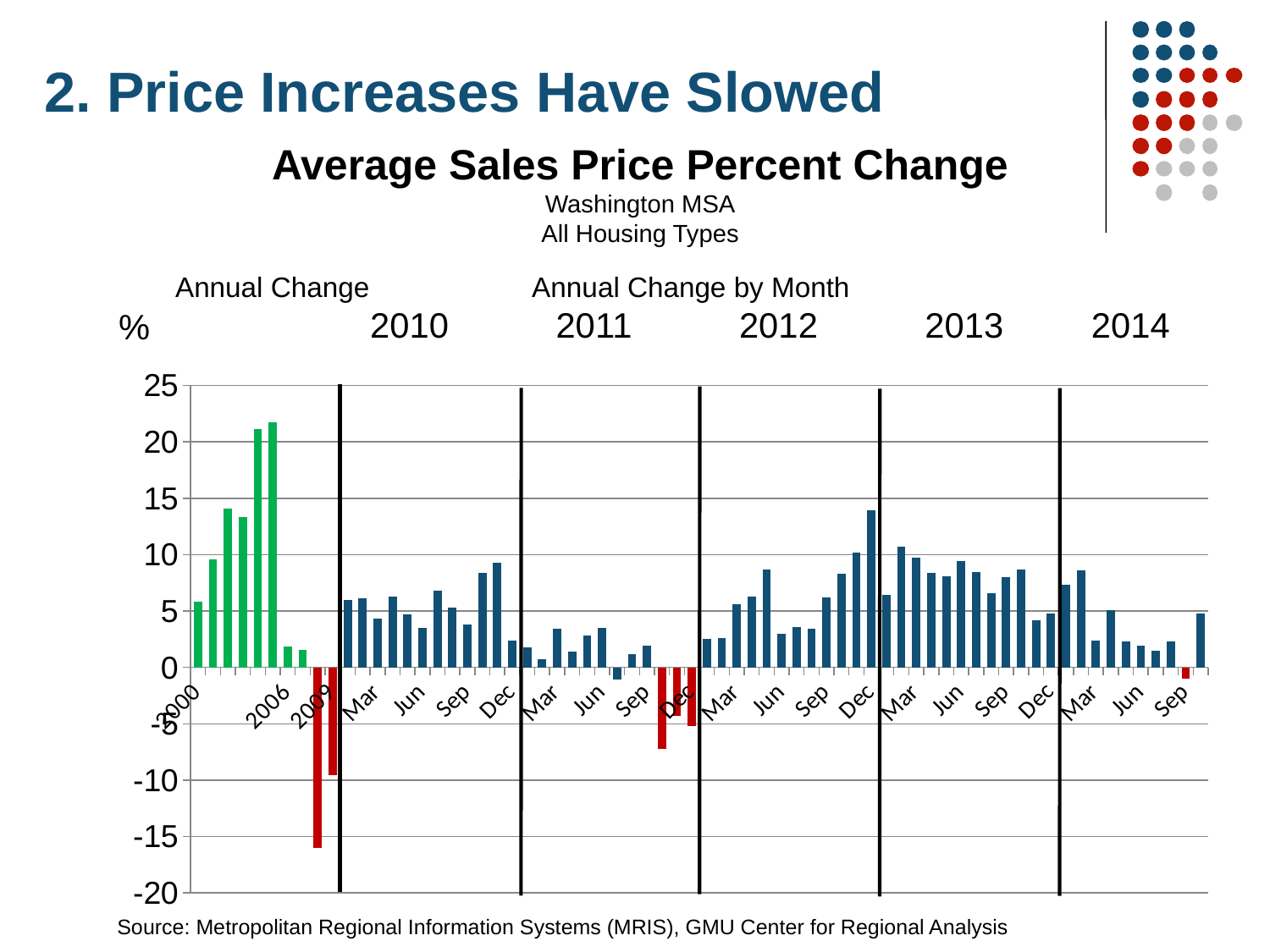
Which is larger, the value for Dec 2012 or the value for Dec 2013? Dec 2012 Which is larger, the value for Dec 2010 or the value for Dec 2011? Dec 2010 In the 'Annual Change by Month' section, which month has the highest value? Dec 2012 Is the value for Dec 2010 greater or less than 5? less What colour are the bars that show negative values? Red How many years are labelled in the 'Annual Change by Month' section of the chart? 5 Which month in 2012 has the highest value? Dec What is the title of the chart? Average Sales Price Percent Change In 2014, do the monthly values generally rise or fall from Mar to Sep? Fall What kind of chart is shown on the slide? Bar chart Is the value for Dec 2012 greater or less than 10? greater Is the value for Sep 2014 greater or less than 0? less